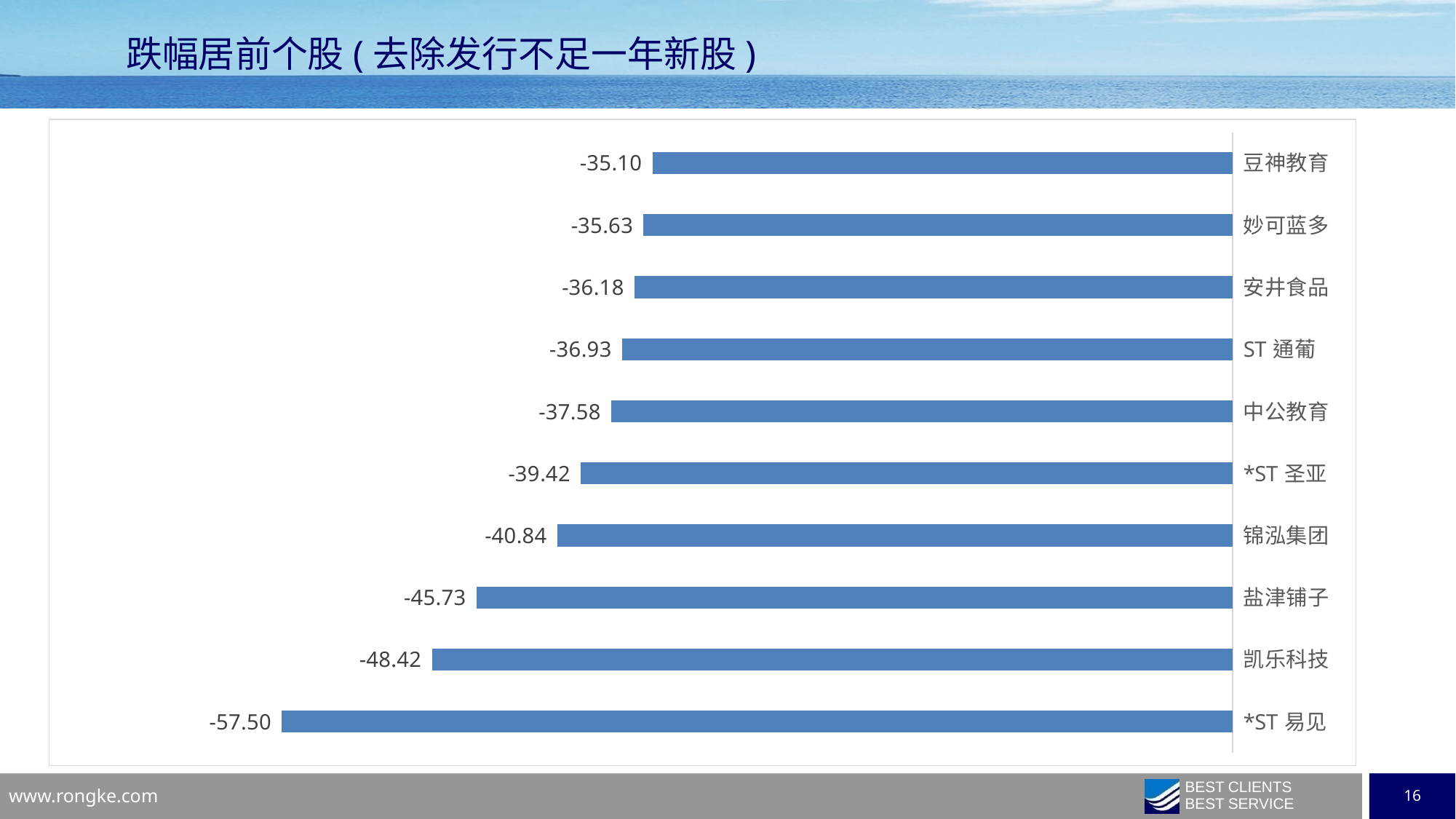
What is the title of the slide? 跌幅居前个股（去除发行不足一年新股） What is the value shown for 盐津铺子? -45.73 Which stock has the highest (least negative) value on the chart? 豆神教育 What is the value shown for 豆神教育? -35.10 What is the difference between the values for 凯乐科技 and *ST 易见? 9.08 Which stock has the lowest (most negative) value on the chart? *ST 易见 How many stocks are shown on the chart? 10 What is the value shown for 中公教育? -37.58 Which has the larger (less negative) value, 锦泓集团 or 盐津铺子? 锦泓集团 What is the value shown for *ST 易见? -57.50 What kind of chart is shown on the slide? Bar chart What is the difference between the values for 豆神教育 and 妙可蓝多? 0.53